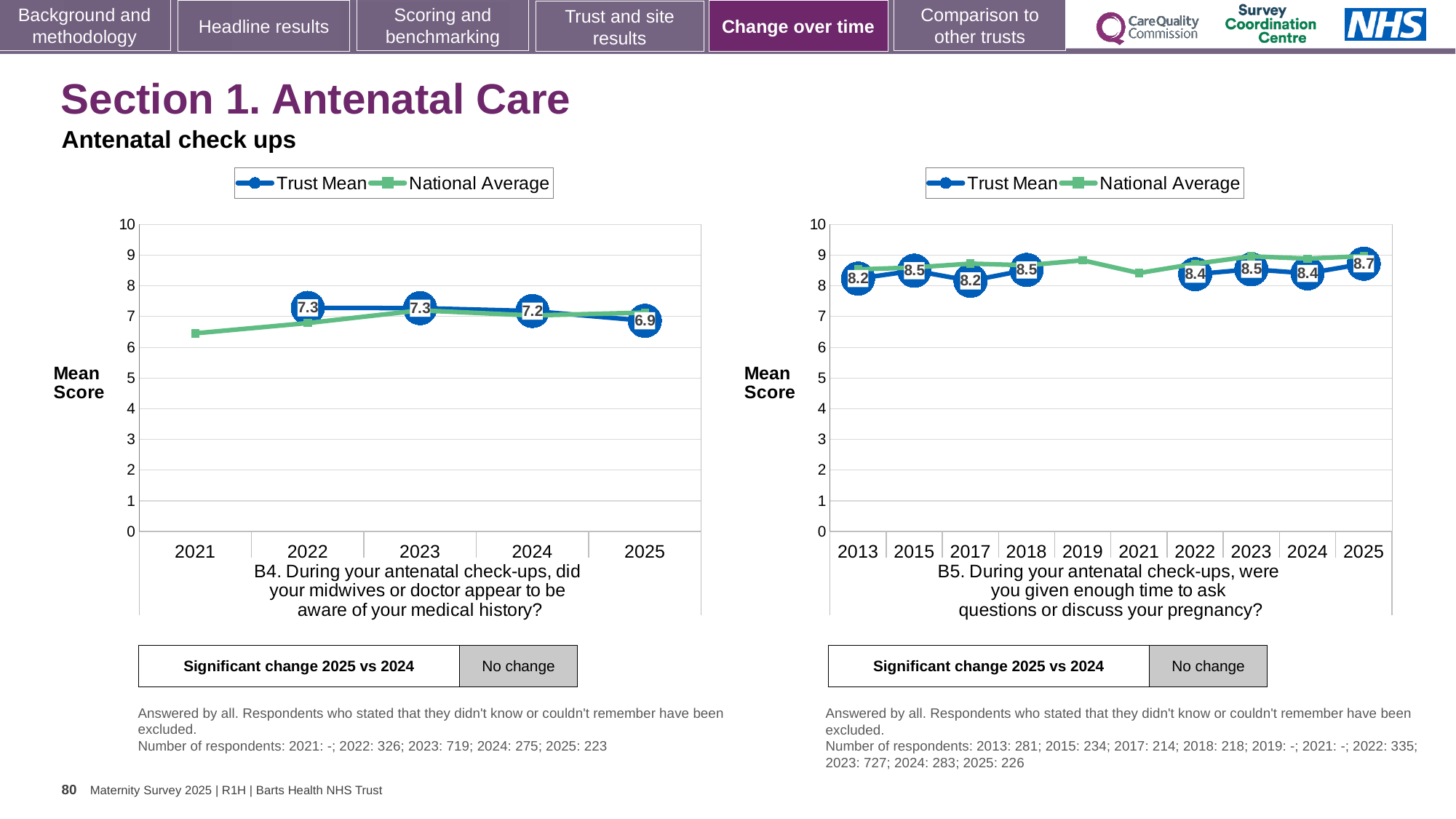
In the B4 chart (left), what is the Trust Mean for 2025? 6.9 In the B4 chart (left), which year has the lowest labelled Trust Mean? 2025 In the B4 chart (left), how many series does the legend list? 2 In the B5 chart (right), what is the Trust Mean for 2025? 8.7 In the B4 chart (left), what is the Trust Mean for 2022? 7.3 In the B5 chart (right), what is the difference between the Trust Mean in 2025 and in 2024? 0.3 In the B5 chart (right), is the Trust Mean for 2013 greater or less than 9? less In the B5 chart (right), how many years are shown on the x axis? 10 In the B4 chart (left), what kind of chart is shown? Line chart In the B4 chart (left), what is the difference between the Trust Mean in 2024 and in 2025? 0.3 In the B5 chart (right), which year has the highest labelled Trust Mean? 2025 In the B5 chart (right), what is the Trust Mean for 2017? 8.2